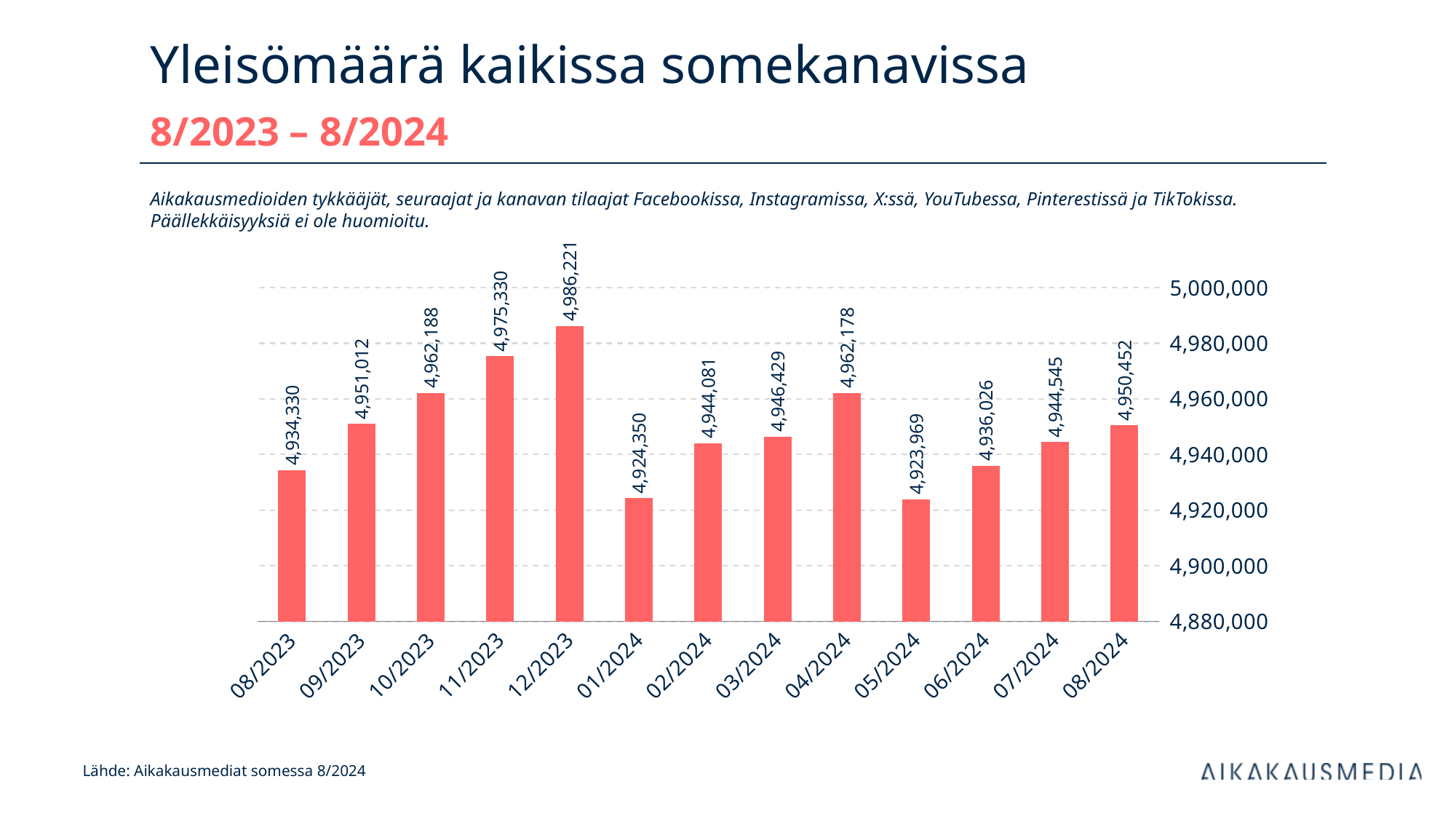
Which month has the lowest value? 05/2024 Is the value for 11/2023 greater or less than 4,960,000? greater Which is larger, the value for 10/2023 or the value for 04/2024? 10/2023 How many months are shown on the x axis? 13 What is the value for 12/2023? 4,986,221 What is the value for 08/2024? 4,950,452 What is the difference between the values for 08/2024 and 08/2023? 16,122 What kind of chart is shown on the slide? bar chart What is the value for 01/2024? 4,924,350 Which month has the highest value? 12/2023 Do the values rise or fall from 08/2023 to 12/2023? rise What is the difference between the values for 12/2023 and 08/2023? 51,891